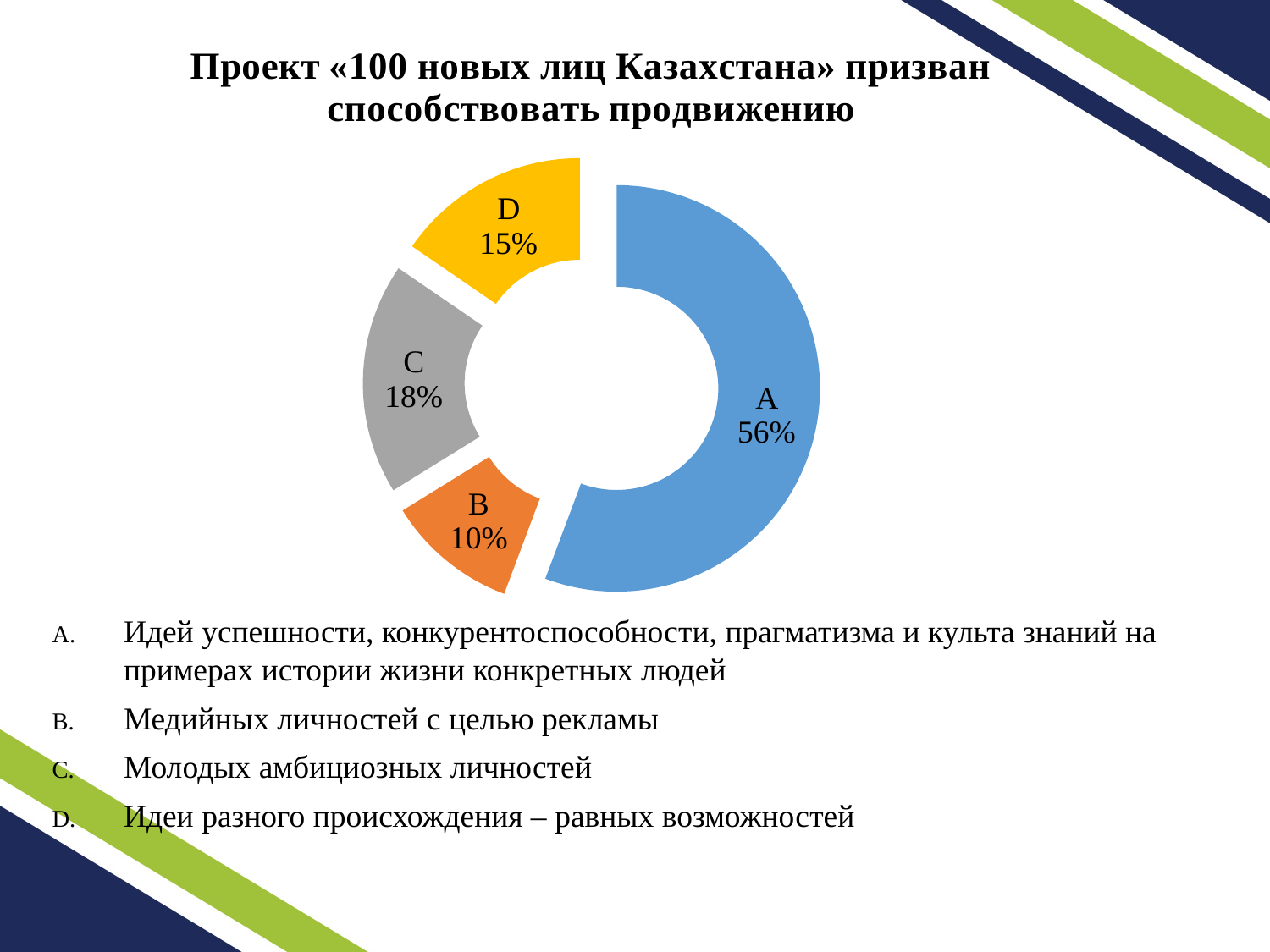
Which segment has a larger share, C or D? C Which segment has the smallest share? B What share of the chart does segment C represent? 18% What share of the chart does segment B represent? 10% What kind of chart is shown on the slide? Doughnut (pie) chart What is the difference in percentage points between segment C and segment D? 3 What share of the chart does segment A represent? 56% What share of the chart does segment D represent? 15% What colour is segment A in the chart? Blue How many segments does the chart have? 4 What is the difference in percentage points between segment A and segment C? 38 Which segment has the largest share? A